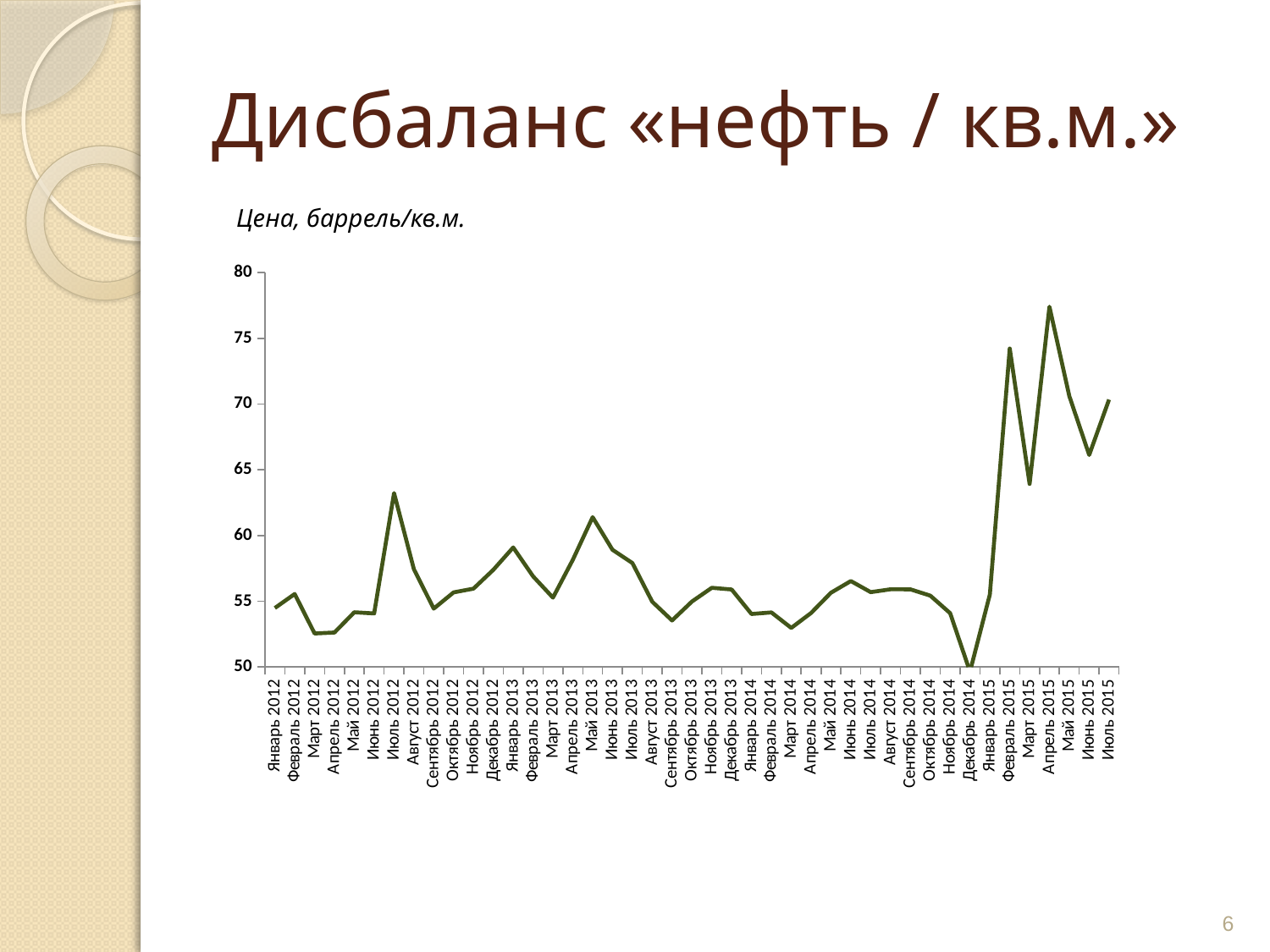
Which is larger, the value for Апрель 2015 or the value for Июль 2012? Апрель 2015 Do the values rise or fall from Июль 2012 to Сентябрь 2012? fall Is the value for Февраль 2015 greater or less than 70? greater What is the title of the slide containing the chart? Дисбаланс «нефть / кв.м.» Is the value for Июнь 2015 greater or less than 70? less Is the value for Март 2012 greater or less than 55? less What kind of chart is shown on the slide? line chart Which month has the highest value on the chart? Апрель 2015 How many monthly data points are plotted on the chart? 43 Which is larger, the value for Март 2014 or the value for Июнь 2014? Июнь 2014 Which month has the lowest value on the chart? Декабрь 2014